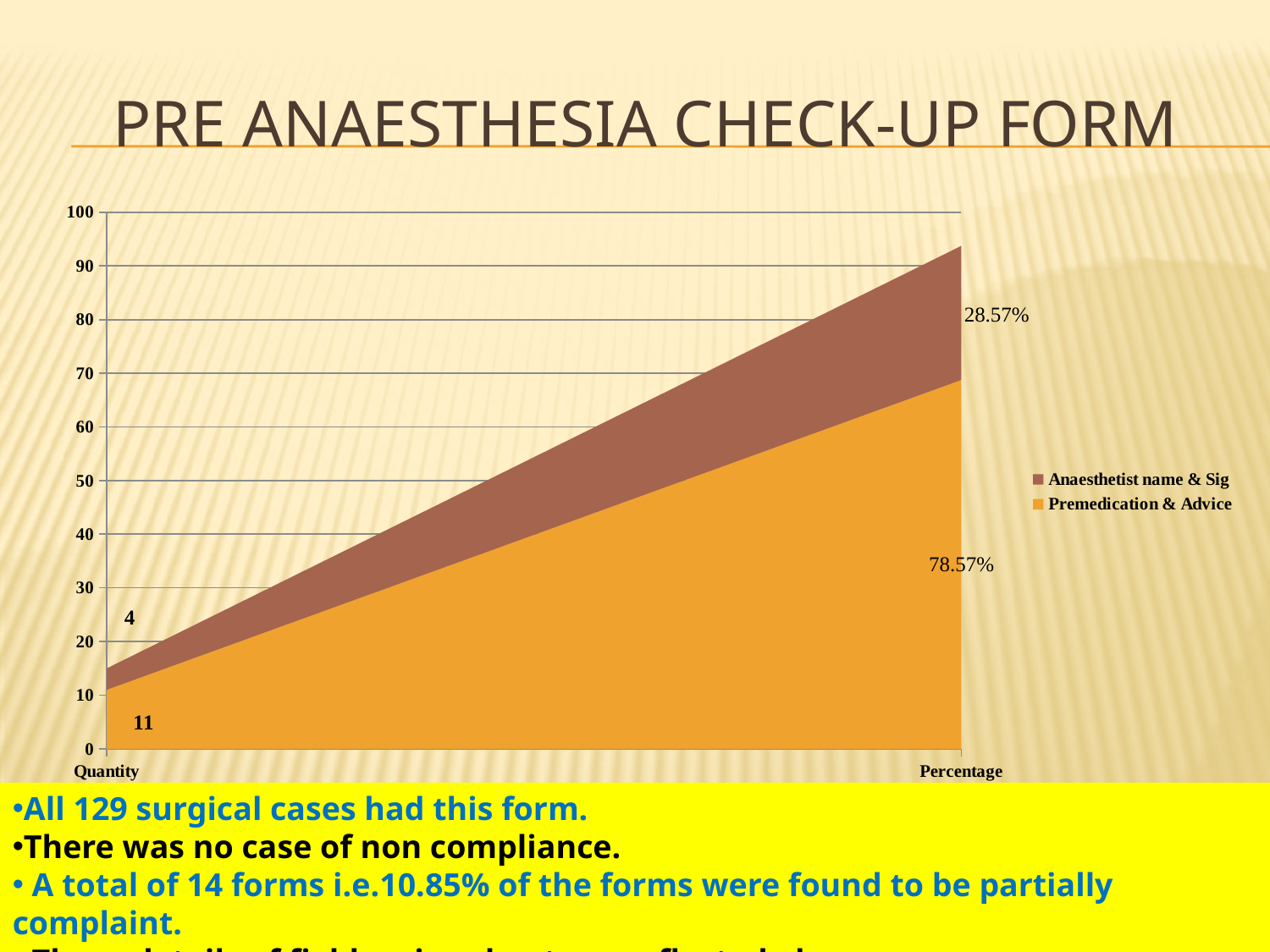
What is the value for Anaesthetist name & Sig at Quantity? 4 Which series has the larger value at Quantity, Premedication & Advice or Anaesthetist name & Sig? Premedication & Advice How many series does the legend list? 2 How many categories are shown on the x axis? 2 What kind of chart is shown on the slide? Stacked area chart What is the value for Premedication & Advice at Percentage? 78.57% What is the title of the slide containing the chart? PRE ANAESTHESIA CHECK-UP FORM Which series has the larger value at Percentage? Premedication & Advice What is the value for Premedication & Advice at Quantity? 11 What is the value for Anaesthetist name & Sig at Percentage? 28.57% What is the difference between the Premedication & Advice and Anaesthetist name & Sig values at Quantity? 7 Which colour represents Premedication & Advice in the legend? Orange